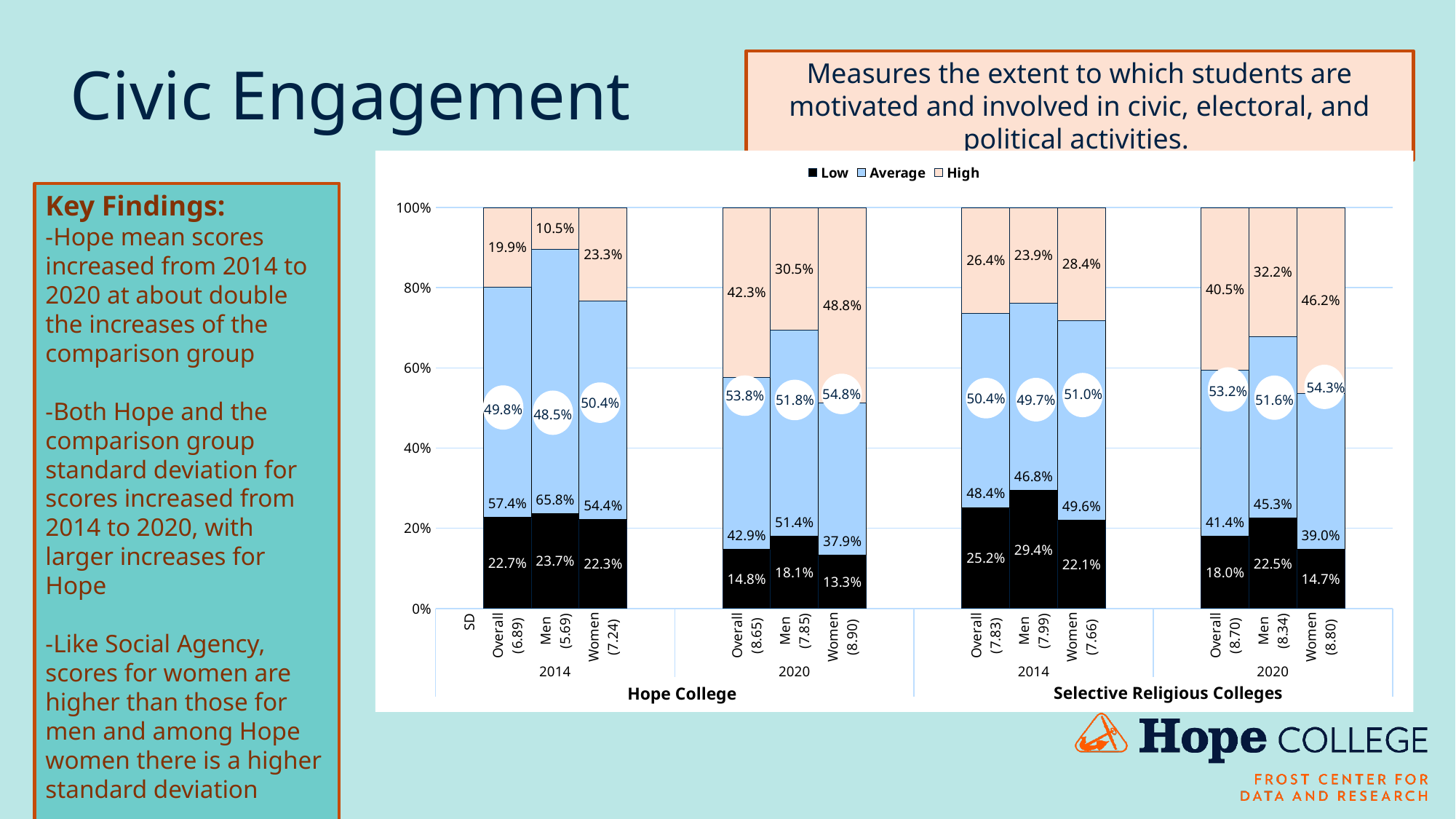
Which bar has the lowest High percentage? Hope College Men 2014 (10.5%) What are the three series named in the legend? Low, Average, High Which bar has the highest High percentage? Hope College Women 2020 (48.8%) What percentage of Hope College women in 2020 scored High on civic engagement? 48.8% Which is larger: the Low percentage for Selective Religious Colleges men in 2014 or for Hope College men in 2014? Selective Religious Colleges men in 2014 (29.4%) What is the difference between the High percentage for Hope College overall in 2020 and in 2014? 22.4 percentage points What is the Low percentage for Hope College men in 2014? 23.7% What is the standard deviation (SD) shown for Hope College women in 2020? 8.90 How many series does the legend list? 3 What kind of chart is shown on the slide? Stacked bar chart What is the Average percentage for Selective Religious Colleges overall in 2020? 41.4% How many bars are plotted in the chart? 12